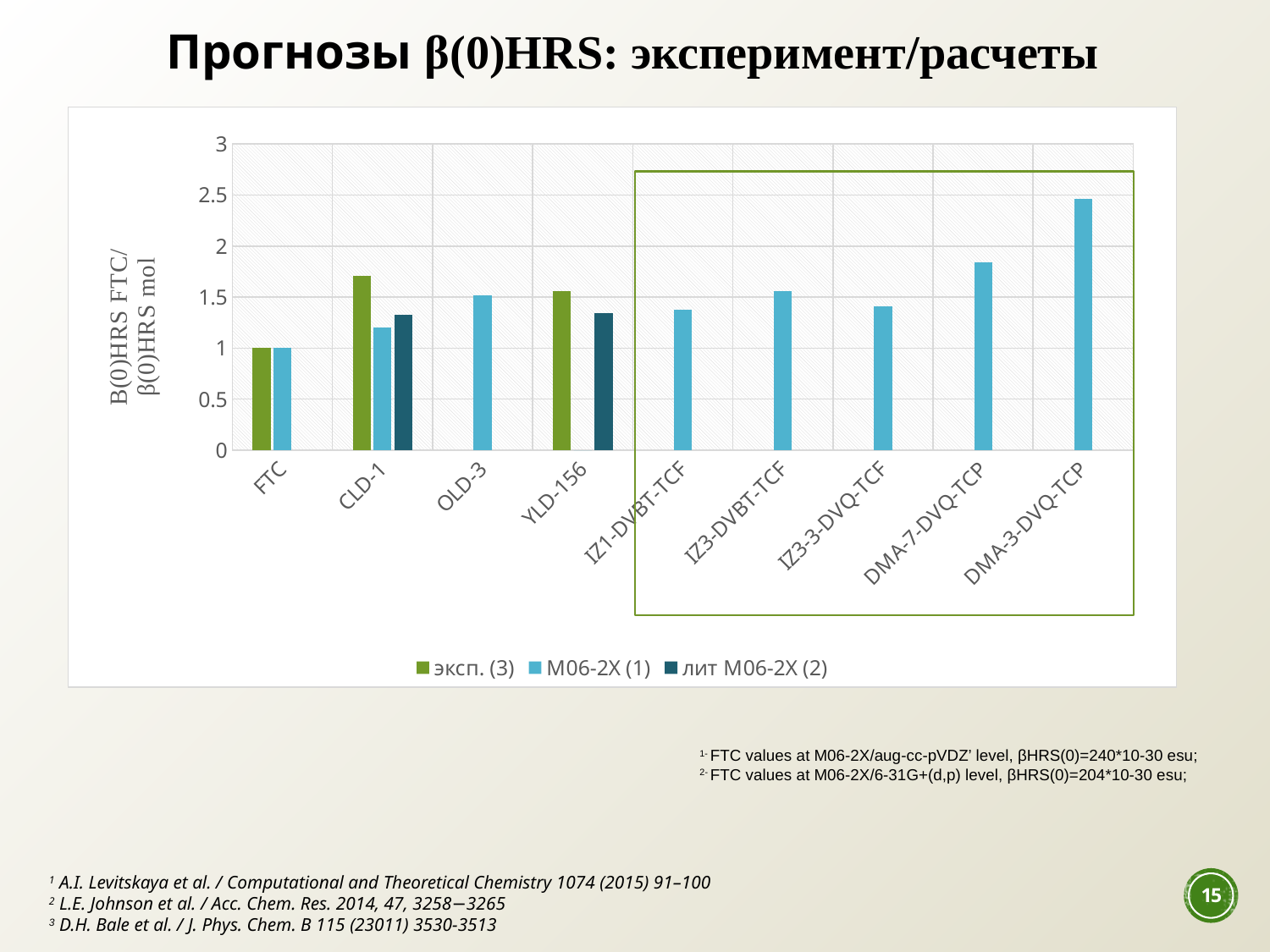
Which categories have a bar for the лит M06-2X (2) series? CLD-1, YLD-156 In the M06-2X (1) series, which is larger: DMA-7-DVQ-TCP or DMA-3-DVQ-TCP? DMA-3-DVQ-TCP For CLD-1, which series has the larger value: эксп. (3) or M06-2X (1)? эксп. (3) What kind of chart is shown on the slide? bar chart What is the value of the M06-2X (1) series for FTC? 1 How many series does the chart legend list? 3 Is the M06-2X (1) value for DMA-3-DVQ-TCP greater or less than 2? greater Which category has the highest value in the M06-2X (1) series? DMA-3-DVQ-TCP Is the M06-2X (1) value for IZ1-DVBT-TCF greater or less than 1.5? less Is the эксп. (3) value for CLD-1 greater or less than 1.5? greater How many categories are shown on the x axis of the chart? 9